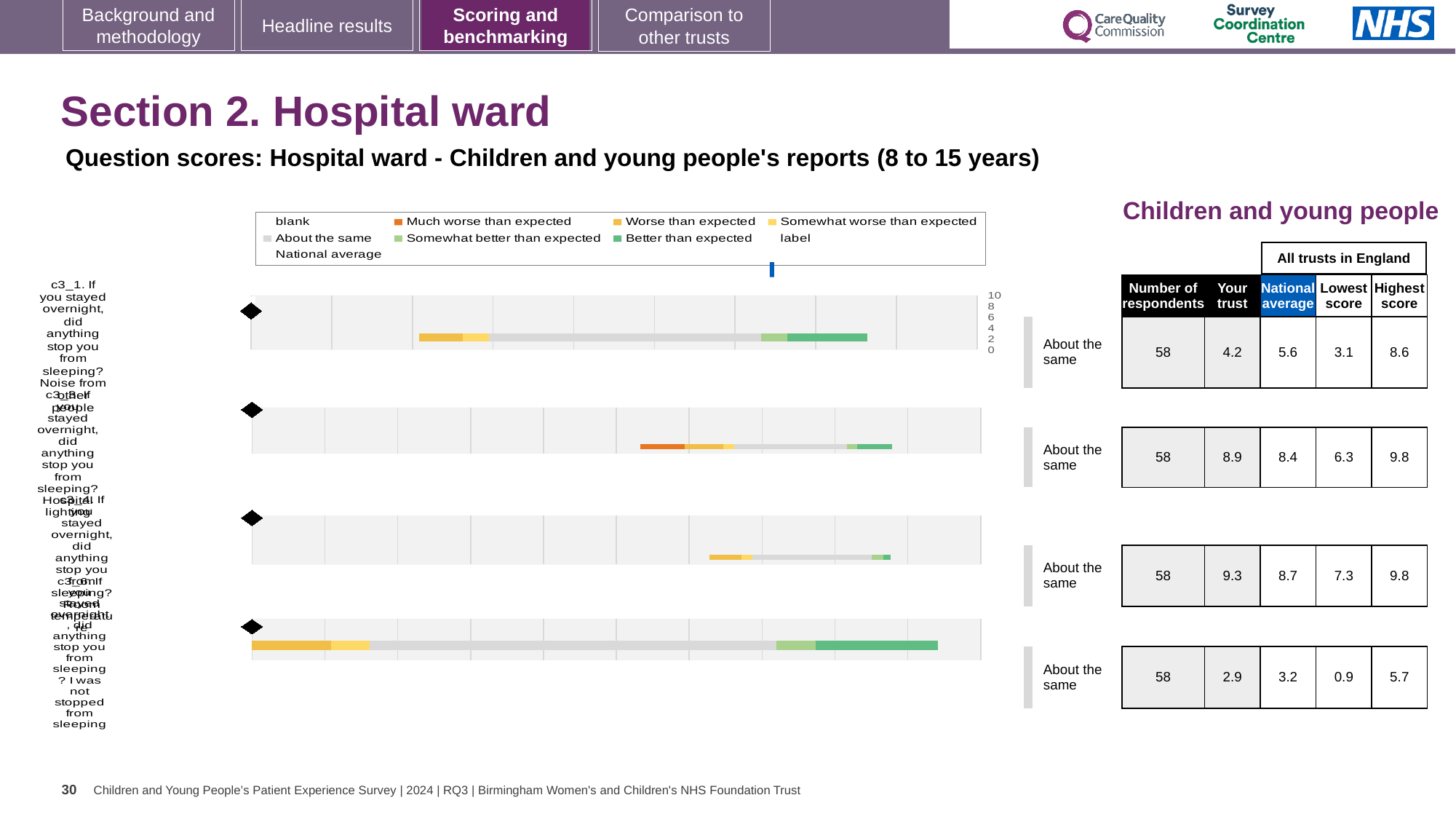
In the table, what is the national average for the top row (c3_1, noise from other people)? 5.6 In the table, what is the number of respondents for the second row? 58 In the table, what is the lowest score for the third row? 7.3 What kind of chart is used for the benchmarking rows on this slide? bar chart In the table, what is the 'Your trust' score for the top row (c3_1, noise from other people)? 4.2 For the top row, what is the difference between the highest score (8.6) and the lowest score (3.1)? 5.5 How many benchmarking bar rows are shown on the slide? 4 For the top row, which is larger: the 'Your trust' score or the national average? national average In the chart legend, which colour represents 'Much worse than expected'? orange Which row has the highest 'Your trust' score in the table? the third row (9.3) In the table, what is the highest score for the bottom row? 5.7 In the chart legend, which colour represents 'Better than expected'? green